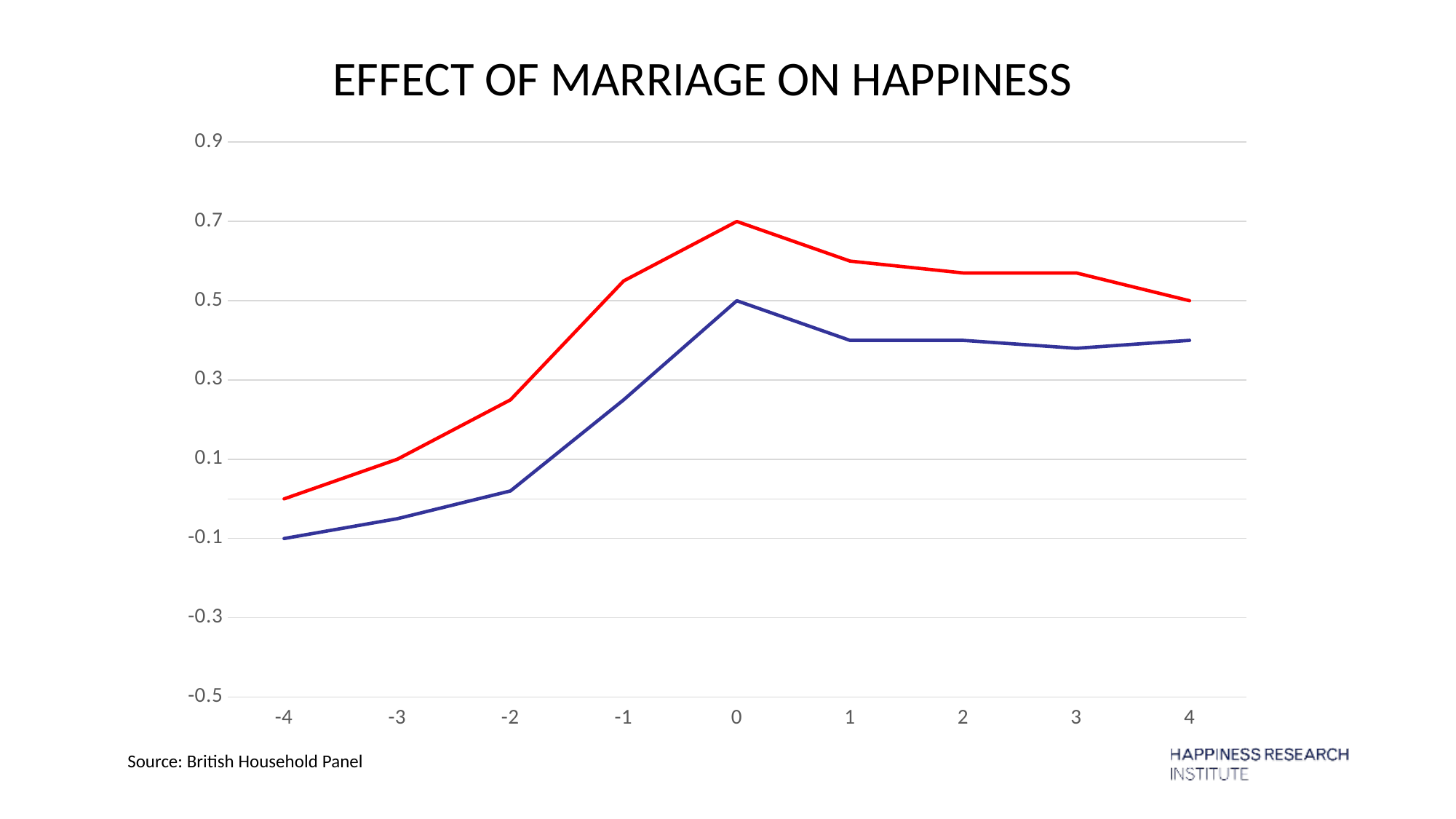
What is the value of the blue line at x = 0? 0.5 What is the value of the red line at x = 0? 0.7 How many points are plotted along the x axis for each line? 9 At which x value is the blue line at its lowest? -4 Does the blue line rise or fall between x = -4 and x = 0? Rise What is the title of the chart? EFFECT OF MARRIAGE ON HAPPINESS What is the value of the red line at x = 4? 0.5 Is the value of the red line at x = 1 greater or less than 0.5? greater What is the difference between the red line and the blue line at x = 0? 0.2 What type of chart is shown on the slide? Line chart At which x value does the red line reach its highest point? 0 What is the value of the blue line at x = -4? -0.1